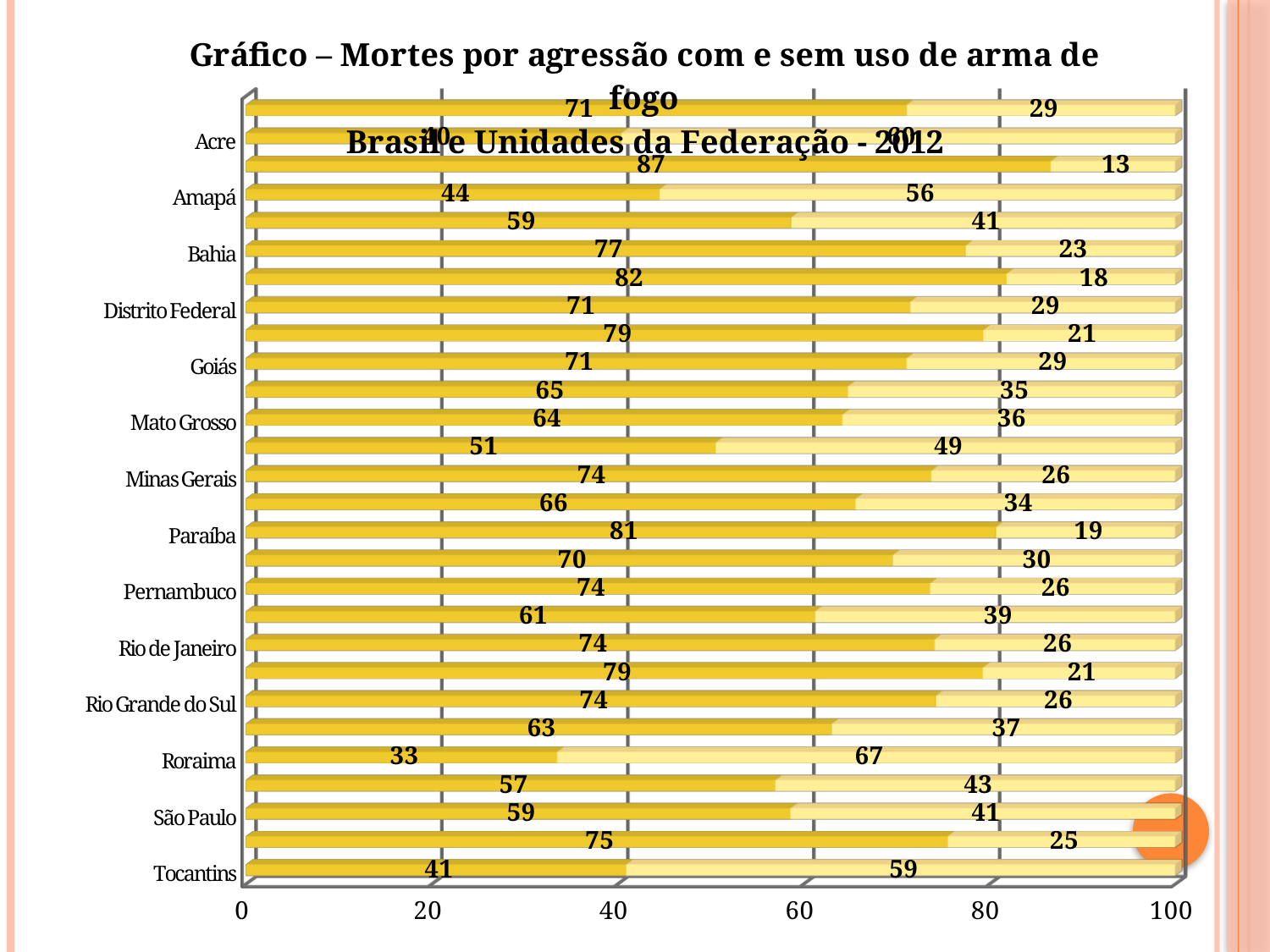
What is the total of the stacked bar for Goiás? 100 Which state has the smallest dark yellow (left) segment in the chart? Roraima What is the value of the light yellow (right) segment for Tocantins? 59 What is the difference between the light yellow and dark yellow segments for Roraima? 34 What year does the chart title refer to? 2012 What type of chart is shown on the slide? Stacked bar chart What is the value of the dark yellow (left) segment for Paraíba? 81 What is the value of the dark yellow (left) segment for Amapá? 44 Which is larger, the dark yellow segment for Bahia or the dark yellow segment for Mato Grosso? Bahia What is the value of the light yellow (right) segment for Bahia? 23 How many state names are labeled on the vertical axis? 14 What is the value of the dark yellow (left) segment for Roraima? 33